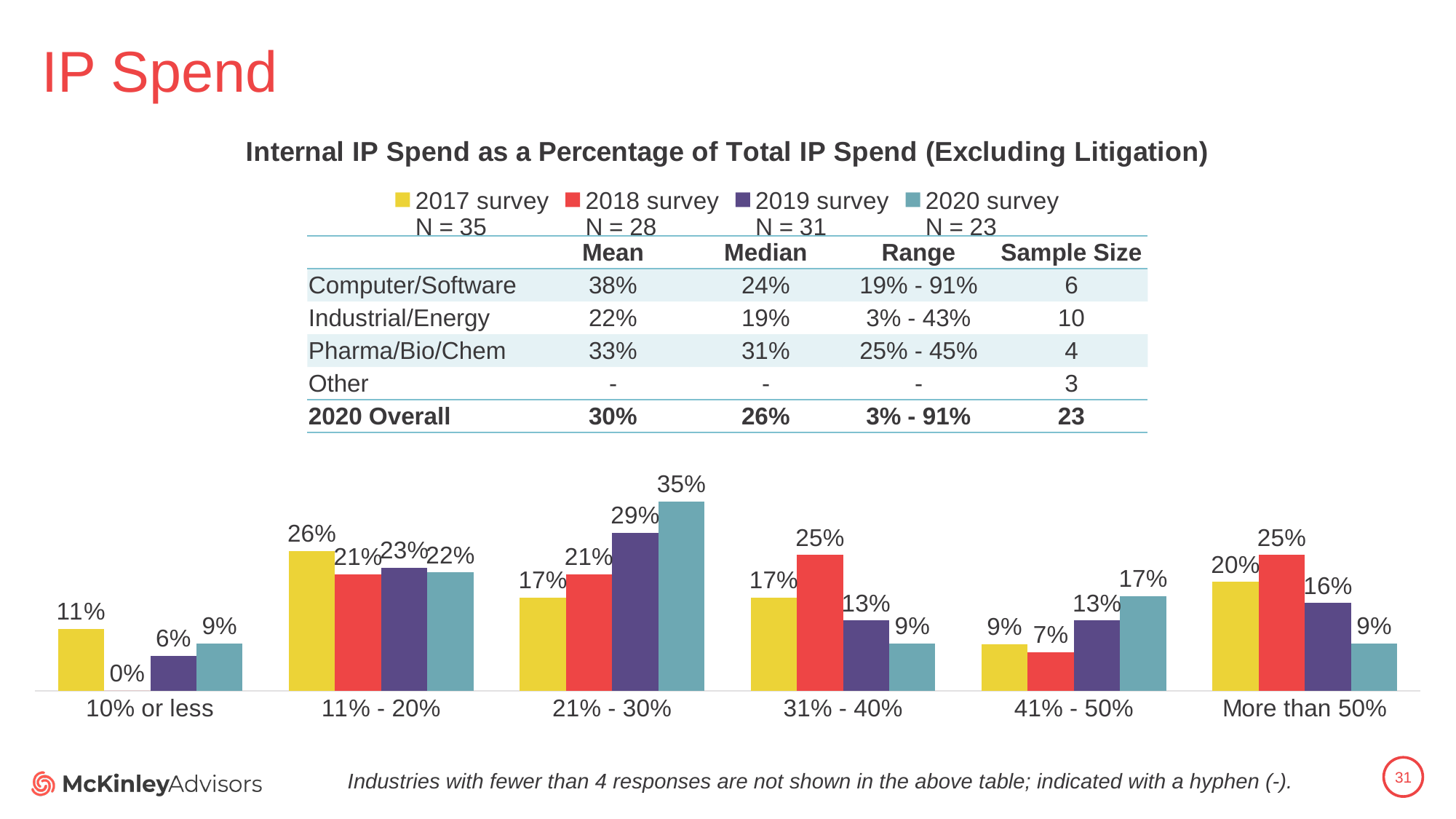
What is the sample size (N) for the 2020 survey shown in the legend? 23 Which category has the lowest value for the 2018 survey? 10% or less How many series does the legend list? 4 How many categories are shown on the x axis? 6 In the 31% - 40% category, which is larger: the 2018 survey value or the 2020 survey value? 2018 survey What is the difference between the 2020 survey and the 2017 survey values in the 21% - 30% category? 18% Which category has the highest value for the 2020 survey? 21% - 30% What is the value for the 2018 survey in the 10% or less category? 0% What is the value for the 2017 survey in the 11% - 20% category? 26% What is the value for the 2019 survey in the More than 50% category? 16% What kind of chart is shown on the slide? Bar chart What is the value for the 2020 survey in the 21% - 30% category? 35%